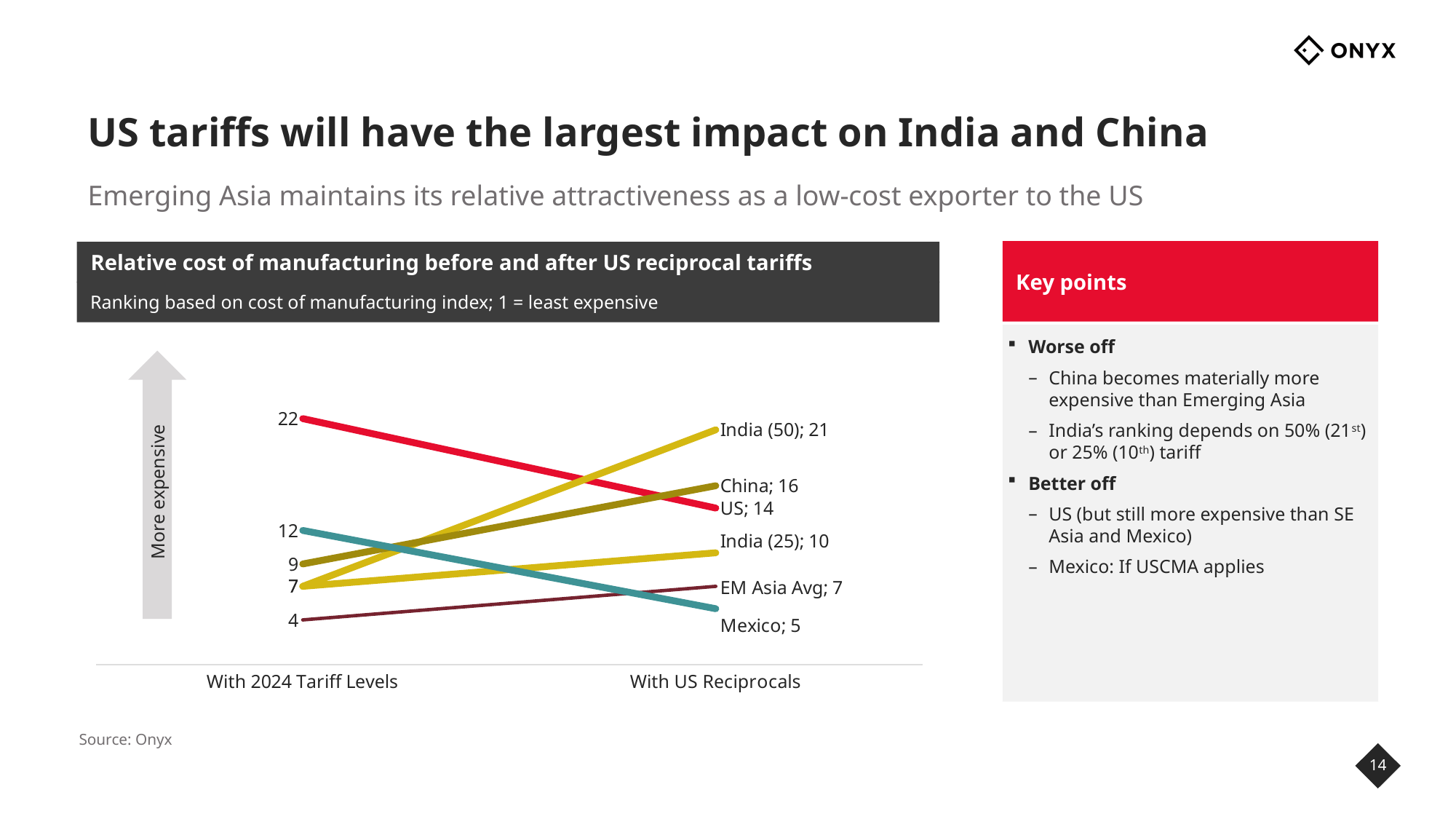
Which series has the lowest value under "With US Reciprocals"? Mexico Which series has the highest value under "With US Reciprocals"? India (50) What is the value for EM Asia Avg under "With 2024 Tariff Levels"? 4 What is the title of the chart? Relative cost of manufacturing before and after US reciprocal tariffs How many categories are shown on the x axis? 2 Does the US line rise or fall from "With 2024 Tariff Levels" to "With US Reciprocals"? Fall Under "With US Reciprocals", which is larger: China or India (25)? China What is the value for the US under "With 2024 Tariff Levels"? 22 What is the value for India (50) under "With US Reciprocals"? 21 By how much does the US value change from "With 2024 Tariff Levels" (22) to "With US Reciprocals" (14)? 8 What is the value for China under "With US Reciprocals"? 16 What is the value for Mexico under "With US Reciprocals"? 5